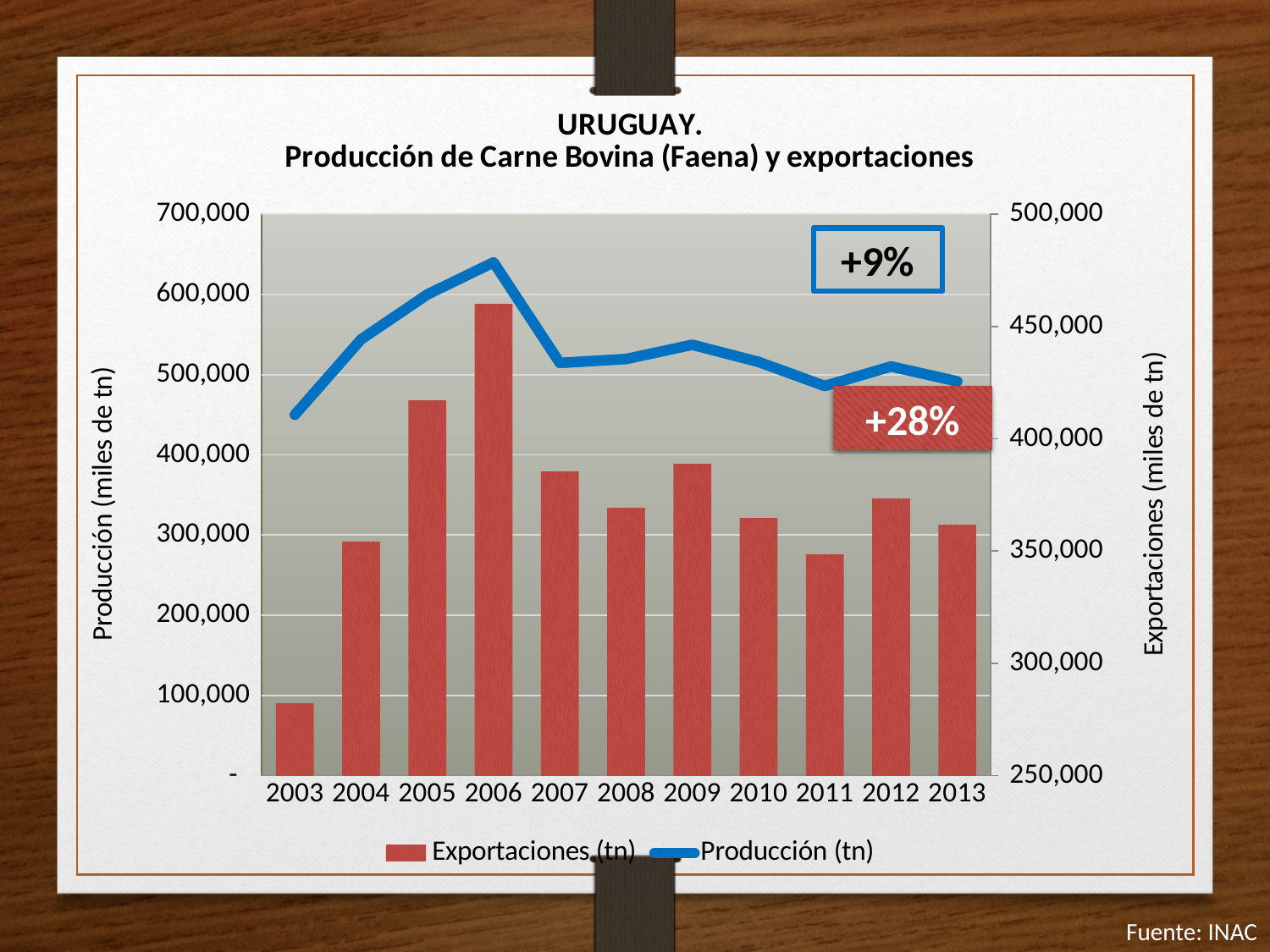
How many series does the legend list? 2 In which year is the Producción (tn) line at its lowest point? 2003 Is the Exportaciones (tn) value for 2006 greater or less than 500,000? less Is the Exportaciones (tn) value for 2011 greater or less than 300,000? greater What percentage is shown in the blue-outlined box on the chart? +9% Which year has the larger Exportaciones (tn) value, 2005 or 2007? 2005 Is the Exportaciones (tn) value for 2003 greater or less than 100,000? greater How many years are shown on the x axis? 11 What kind of chart is shown on the slide? A combined bar and line chart In which year does the Producción (tn) line reach its highest point? 2006 In which year is the Exportaciones (tn) bar highest? 2006 In which year is the Exportaciones (tn) bar lowest? 2003